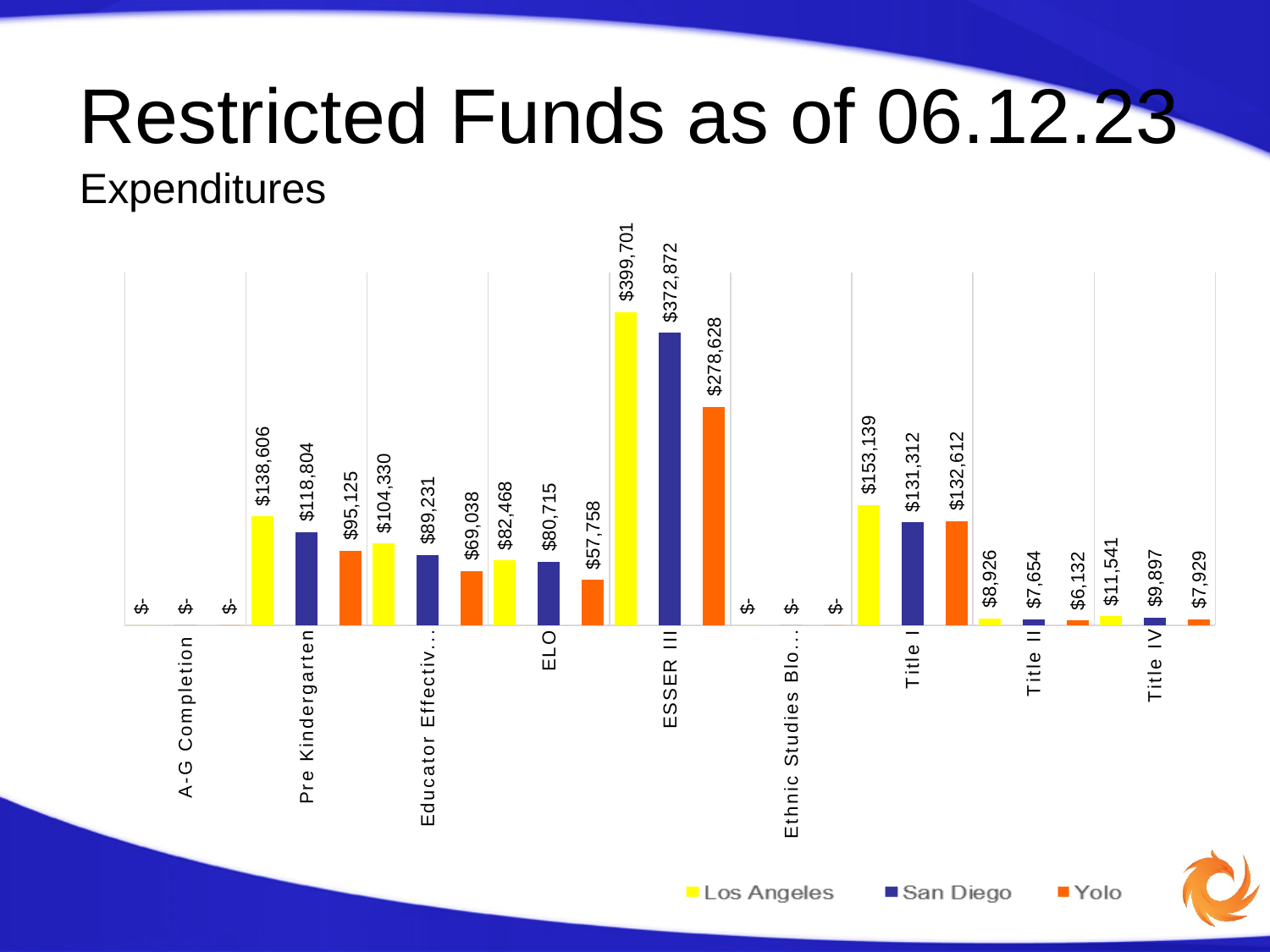
What is the Los Angeles expenditure for ESSER III? $399,701 Which category has the highest expenditure for San Diego? ESSER III What is the difference between the Los Angeles and San Diego expenditures for ESSER III? $26,829 Among the categories with non-zero values, which has the lowest Yolo expenditure? Title II What is the San Diego expenditure for Title IV? $9,897 How many series does the legend list? 3 What type of chart is shown on the slide? Bar chart For Title I, which is larger: the San Diego expenditure or the Yolo expenditure? Yolo What is the difference between the Los Angeles and Yolo expenditures for Pre Kindergarten? $43,481 What is the Los Angeles expenditure for Title II? $8,926 How many categories are shown on the x axis? 9 What is the Yolo expenditure for Pre Kindergarten? $95,125